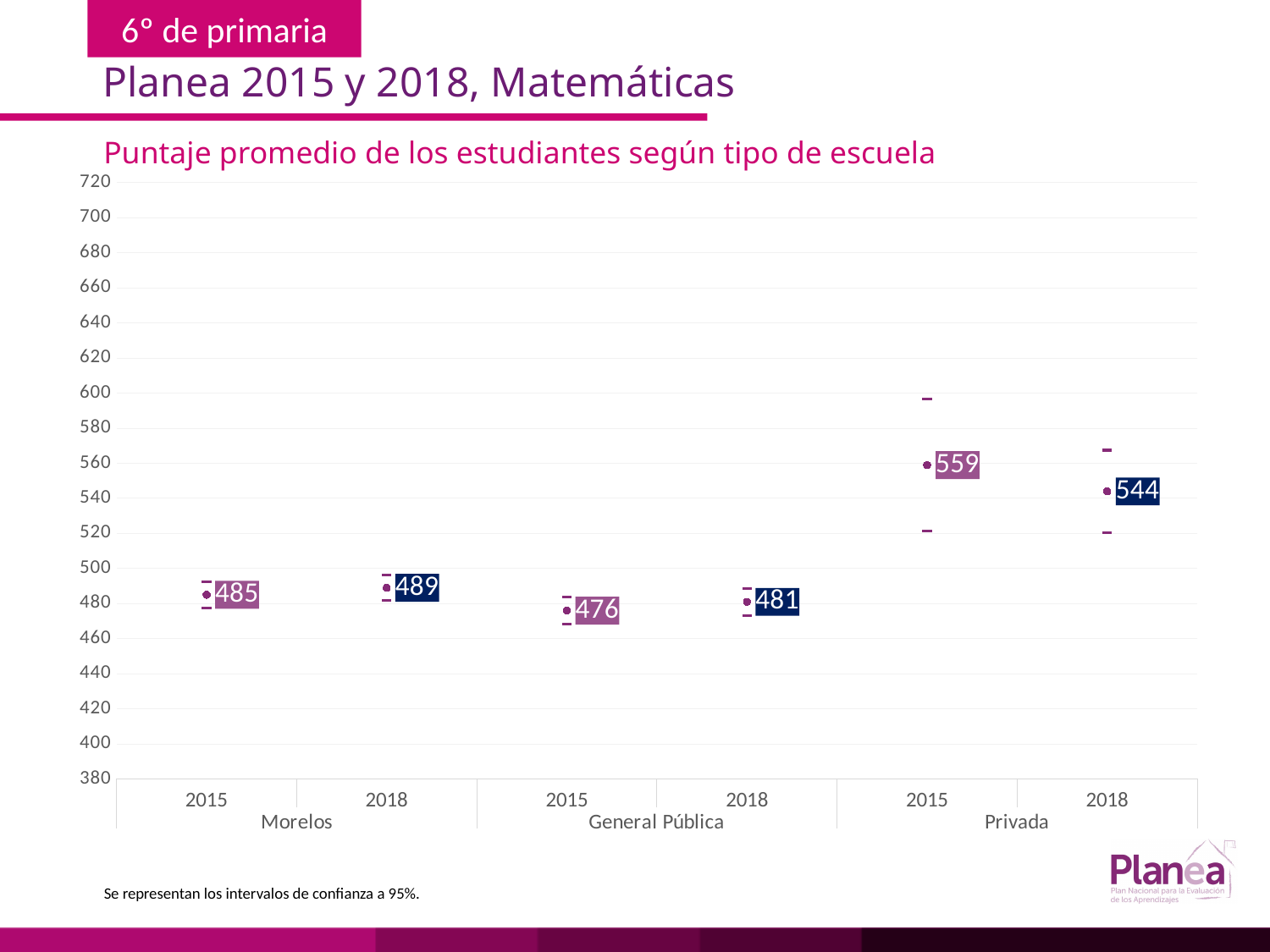
What is the average score for General Pública schools in 2015? 476 What is the average score for Morelos in 2018? 489 Did the Privada average score rise or fall from 2015 to 2018? fall Which group and year has the highest average score? Privada 2015 What is the difference between the General Pública scores in 2018 and 2015? 5 Which is larger, the Morelos 2018 score or the General Pública 2018 score? Morelos 2018 Which group and year has the lowest average score? General Pública 2015 What is the title of the chart? Puntaje promedio de los estudiantes según tipo de escuela What is the average score for Privada schools in 2018? 544 What is the difference between the Privada scores in 2015 and 2018? 15 What is the average score for Morelos in 2015? 485